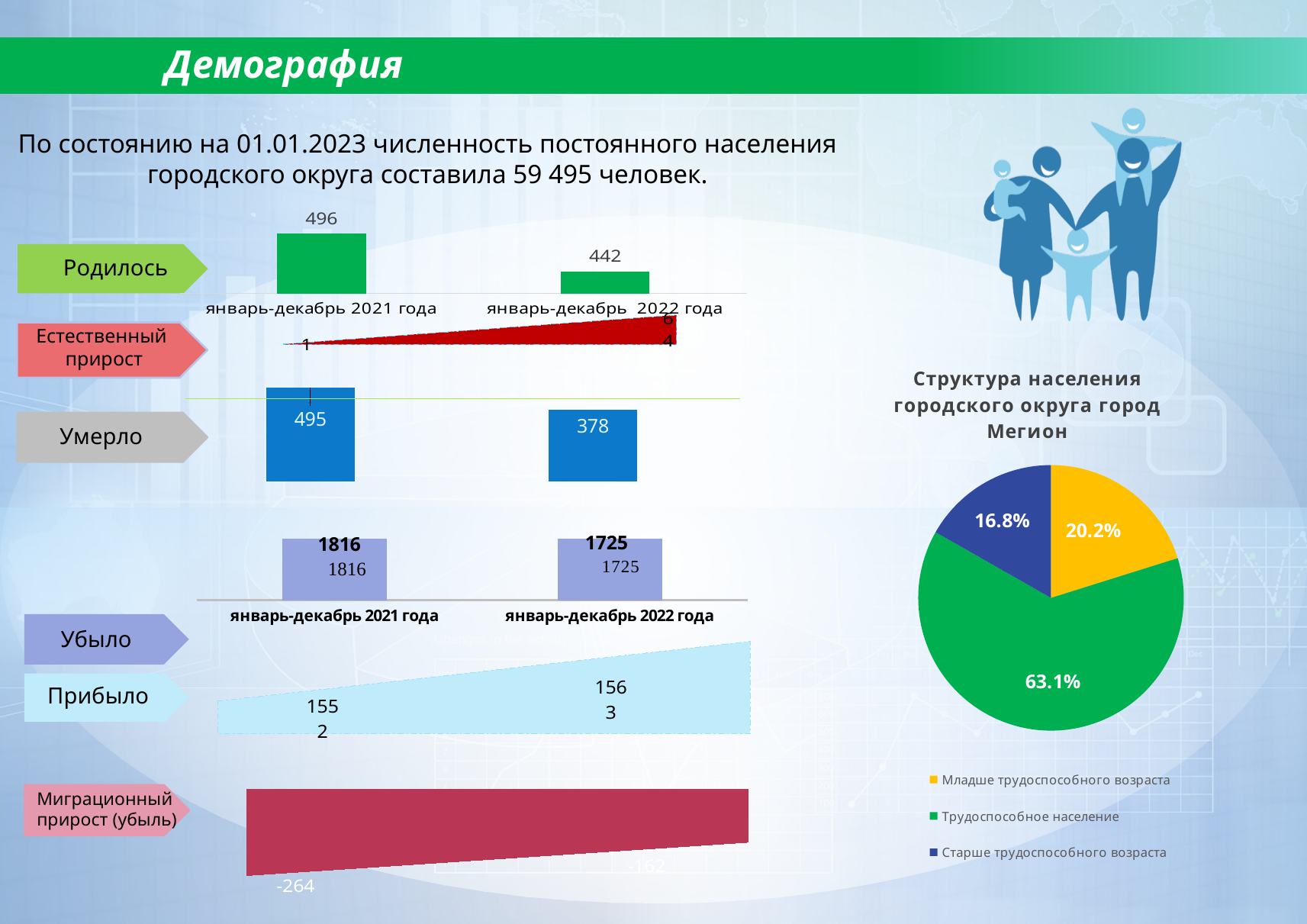
How many categories does the legend of the pie chart 'Структура населения городского округа город Мегион' list? 3 In the 'Миграционный прирост (убыль)' chart, what is the value for 2021? -264 In the 'Родилось' bar chart, what is the difference between the 2021 and 2022 values? 54 In the pie chart 'Структура населения городского округа город Мегион', what share is 'Трудоспособное население'? 63.1% In the 'Убыло' bar chart, which period has the higher value? январь-декабрь 2021 года In the 'Родилось' bar chart, what is the value for январь-декабрь 2022 года? 442 In the 'Умерло' bar chart, what is the difference between the 2021 and 2022 values? 117 In the 'Родилось' bar chart, what is the value for январь-декабрь 2021 года? 496 In the 'Умерло' bar chart, what is the value for январь-декабрь 2021 года? 495 In the pie chart 'Структура населения городского округа город Мегион', which category has the smallest share? Старше трудоспособного возраста In the 'Убыло' bar chart, what is the value for январь-декабрь 2022 года? 1725 In the 'Умерло' bar chart, which period has the lower value? январь-декабрь 2022 года